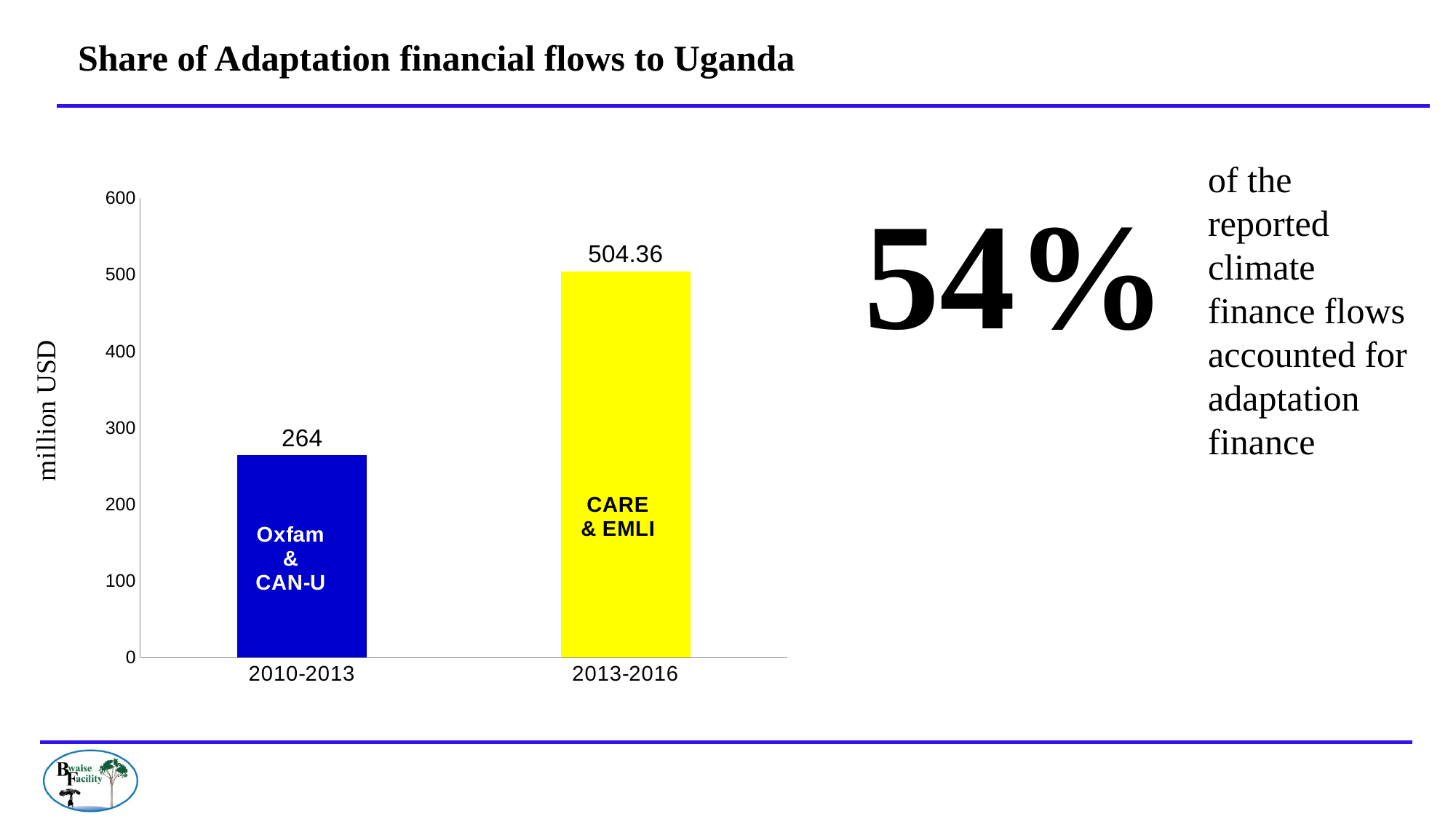
Which is larger, the value for 2010-2013 or the value for 2013-2016? 2013-2016 What kind of chart is shown on the slide? bar chart Is the value for 2010-2013 greater or less than 300? less Do the values rise or fall from 2010-2013 to 2013-2016? rise Is the value for 2013-2016 greater or less than 500? greater Which period has the highest value? 2013-2016 What is the value for 2010-2013? 264 What is the difference between the values for 2013-2016 and 2010-2013? 240.36 What is the value for 2013-2016? 504.36 What is the label on the y axis of the chart? million USD Which period has the lowest value? 2010-2013 How many periods are shown on the x axis? 2